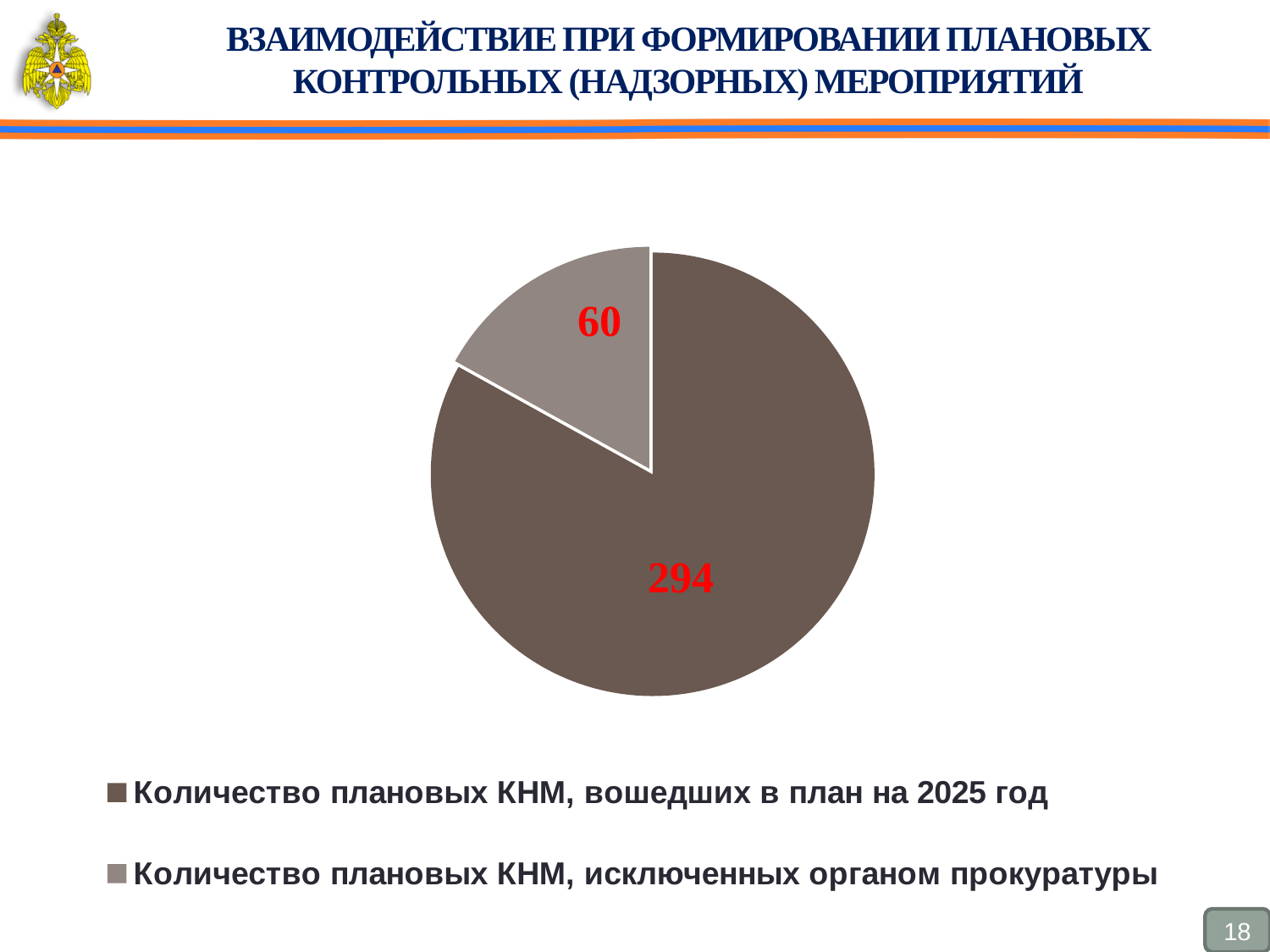
Which is larger: the number of planned KNM included in the 2025 plan or the number excluded by the prosecutor's office? Количество плановых КНМ, вошедших в план на 2025 год How many slices does the pie chart have? 2 Which colour represents "Количество плановых КНМ, исключенных органом прокуратуры" in the pie chart? Grey (the lighter slice) What is the total of the two values shown in the pie chart? 354 How many entries does the legend list? 2 What is the value for "Количество плановых КНМ, вошедших в план на 2025 год"? 294 What is the value for "Количество плановых КНМ, исключенных органом прокуратуры"? 60 What is the difference between the number of planned KNM included in the 2025 plan and the number excluded by the prosecutor's office? 234 Which category has the largest slice of the pie? Количество плановых КНМ, вошедших в план на 2025 год What type of chart is shown on the slide? Pie chart Which category has the smallest slice of the pie? Количество плановых КНМ, исключенных органом прокуратуры